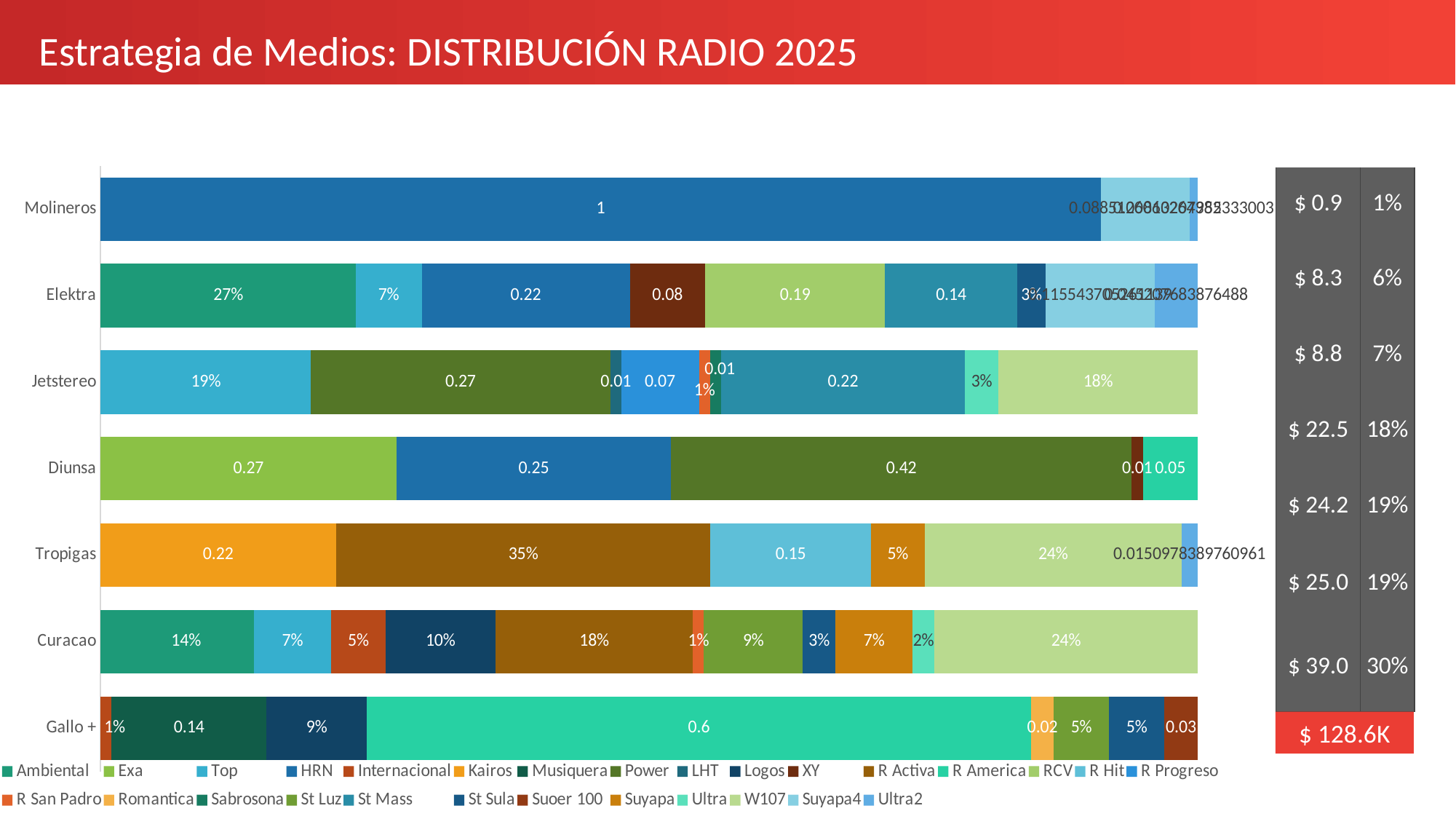
What is the label on the largest segment of the Diunsa bar? 0.42 What is the label on the first (leftmost) segment of the Elektra bar? 27% How many series does the chart legend list? 28 What total value is shown in the red box at the bottom of the right-hand table? $ 128.6K How many segments make up the Diunsa bar? 5 What is the label on the largest segment of the Gallo + bar? 0.6 How many categories (retailers) are listed on the vertical axis of the chart? 7 What is the label on the largest segment of the Tropigas bar? 35% What is the title of the slide? Estrategia de Medios: DISTRIBUCIÓN RADIO 2025 In the Curacao bar, what is the difference between the 24% segment and the 14% segment? 10% What is the label on the first (leftmost) segment of the Curacao bar? 14% What kind of chart is shown on the slide? Stacked bar chart